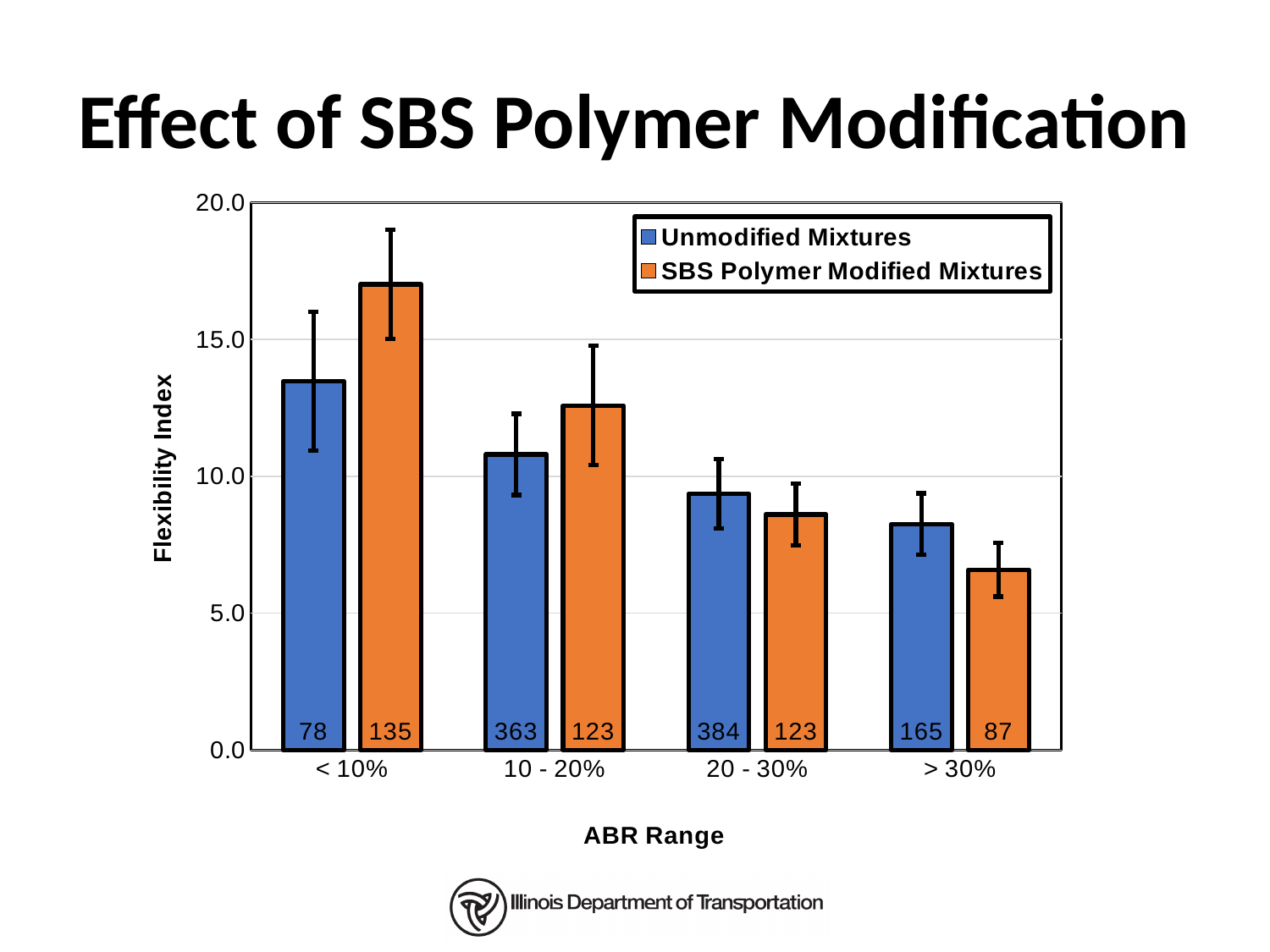
In the < 10% ABR Range, which series has the larger Flexibility Index, Unmodified Mixtures or SBS Polymer Modified Mixtures? SBS Polymer Modified Mixtures What is the label of the y axis? Flexibility Index What number is printed inside the Unmodified Mixtures bar for the 20 - 30% ABR Range? 384 Which ABR Range category has the highest Flexibility Index for SBS Polymer Modified Mixtures? < 10% How many ABR Range categories are shown on the x axis? 4 In the > 30% ABR Range, which series has the larger Flexibility Index, Unmodified Mixtures or SBS Polymer Modified Mixtures? Unmodified Mixtures Is the Flexibility Index for SBS Polymer Modified Mixtures in the < 10% ABR Range greater or less than 15.0? greater Is the Flexibility Index for Unmodified Mixtures in the 20 - 30% ABR Range greater or less than 10.0? less Do the Flexibility Index values for SBS Polymer Modified Mixtures rise or fall as the ABR Range increases along the x axis? fall What kind of chart is shown on the slide? bar chart Which ABR Range category has the lowest Flexibility Index for Unmodified Mixtures? > 30% How many series does the legend list? 2